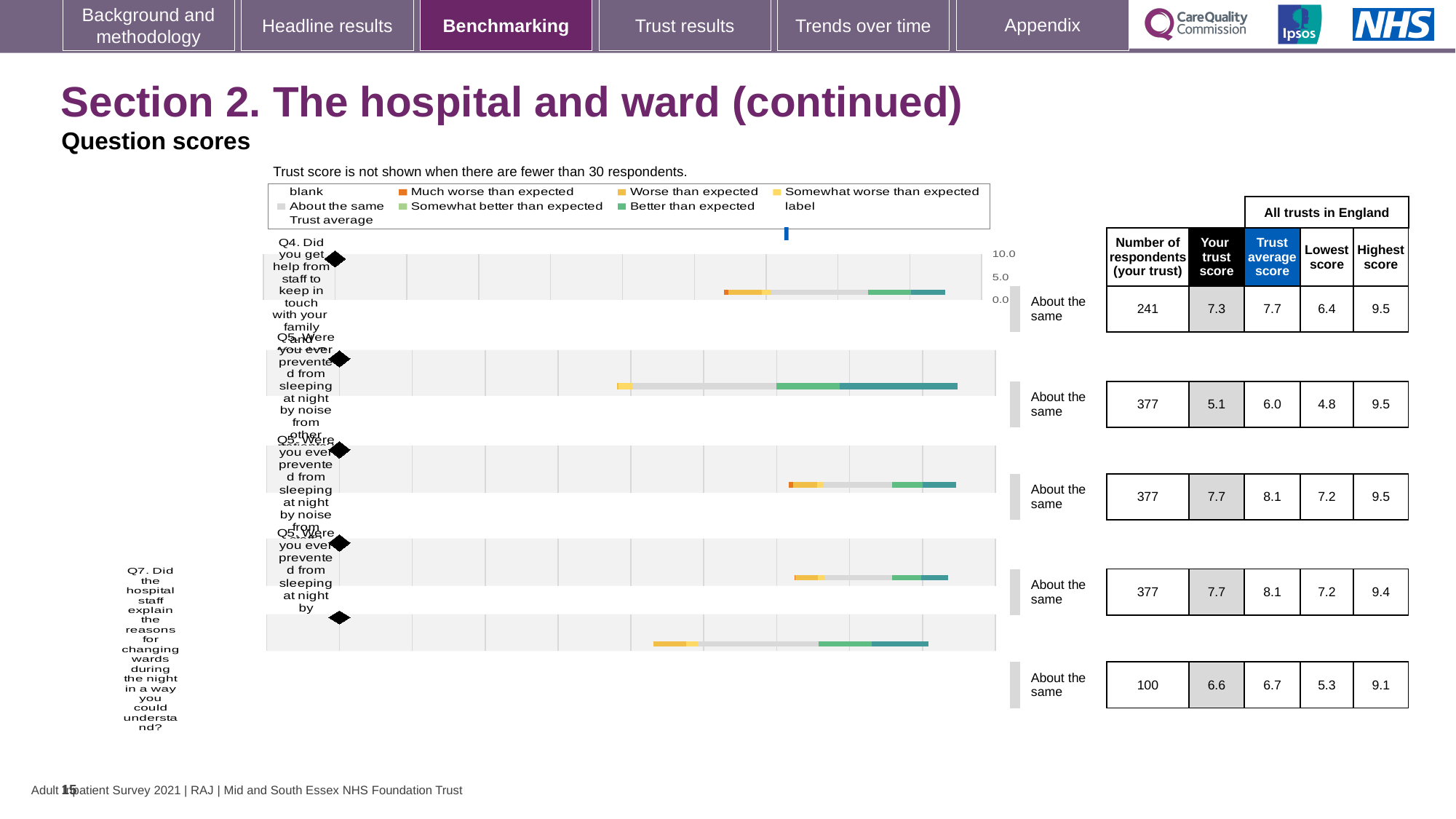
What is the highest score across all trusts in England for Q7? 9.1 How many respondents (your trust) are shown for Q7? 100 What is the lowest 'Your trust score' shown in the table on this slide? 5.1 What kind of chart is used to show the question scores on this slide? bar chart What is the difference between the trust average score and your trust score for Q4? 0.4 For Q4, which is larger: your trust score or the trust average score? Trust average score What is the 'Your trust score' for Q4 (help from staff to keep in touch with family and friends)? 7.3 What is the trust average score for Q4? 7.7 What benchmark category is shown for Q4? About the same What is the 'Your trust score' for Q7 (explaining reasons for changing wards during the night)? 6.6 How many respondents (your trust) are shown for Q4? 241 How many question bars are plotted in the chart? 5